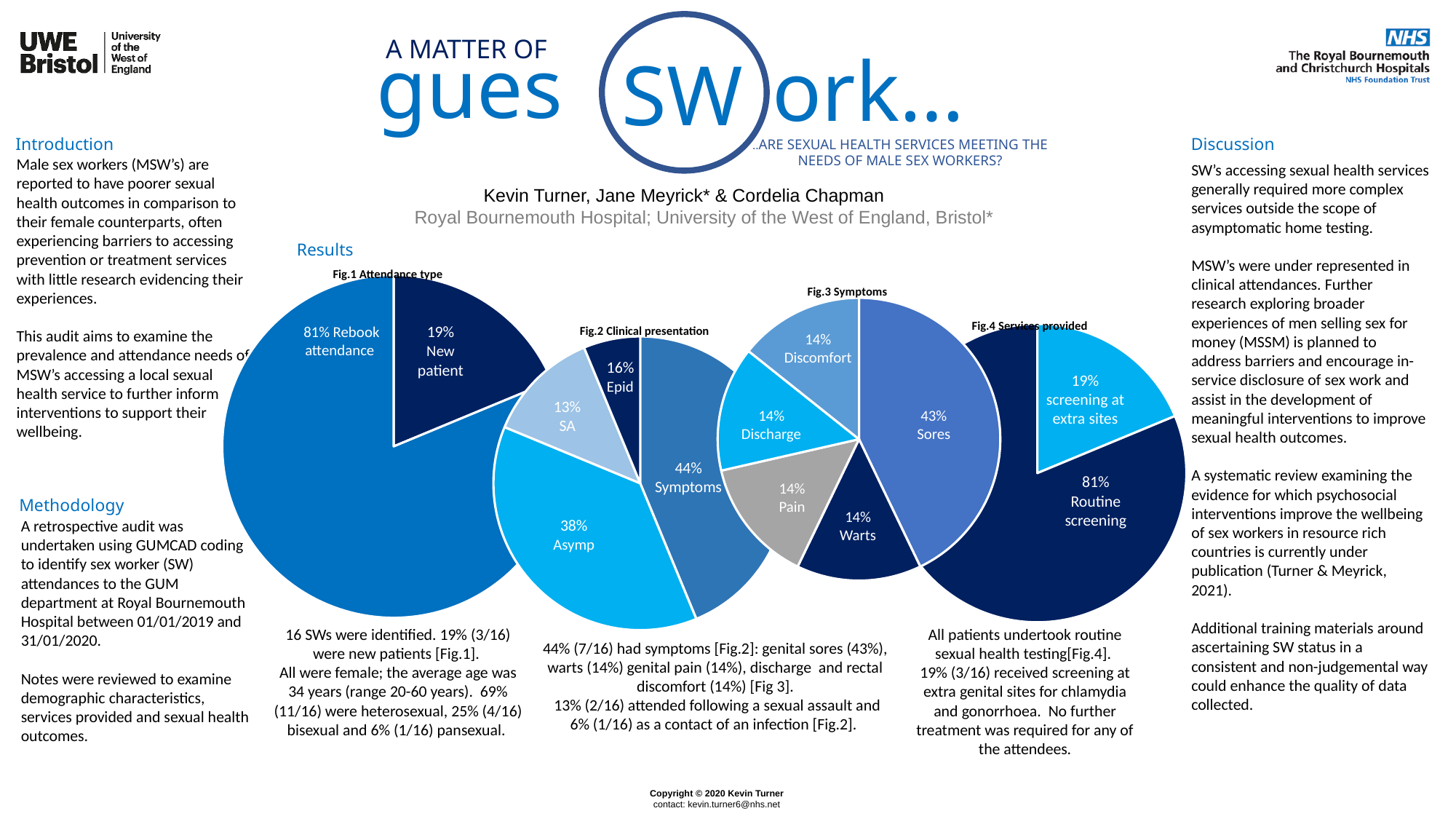
In Fig.2 Clinical presentation, what is the difference between the Symptoms and Asymp percentages? 6% In Fig.1 Attendance type, what share of attendances were new patients? 19% In Fig.3 Symptoms, what percentage is labelled Warts? 14% In Fig.4 Services provided, which is larger: Routine screening or screening at extra sites? Routine screening How many slices does the Fig.3 Symptoms pie chart have? 5 What kind of chart is Fig.1 Attendance type? Pie chart In Fig.2 Clinical presentation, which slice is the largest? Symptoms In Fig.1 Attendance type, what share of attendances were rebook attendances? 81% In Fig.4 Services provided, what percentage received screening at extra sites? 19% In Fig.3 Symptoms, which symptom has the largest share? Sores In Fig.2 Clinical presentation, what percentage is labelled Symptoms? 44% In Fig.2 Clinical presentation, what percentage is labelled SA? 13%